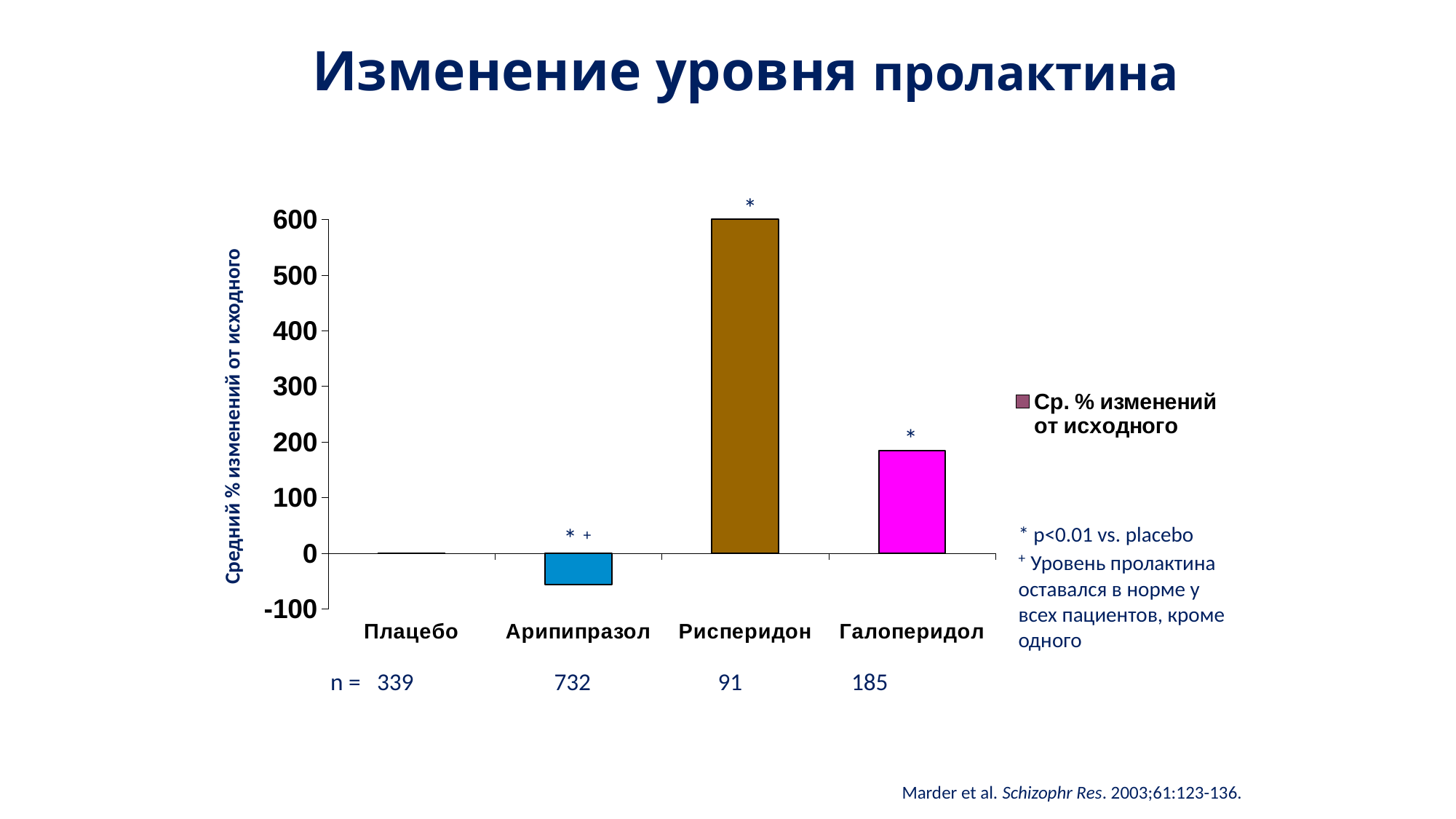
What is the n (number of patients) shown under the Арипипразол bar? 732 Which has the larger mean % change from baseline, Галоперидол or Арипипразол? Галоперидол Which category has the lowest mean % change from baseline in prolactin level? Арипипразол Is the value for Арипипразол greater or less than 0? less What is the legend entry for the plotted series? Ср. % изменений от исходного Is the value for Галоперидол greater or less than 200? less Is the value for Галоперидол greater or less than 100? greater How many series does the chart legend list? 1 Which has the larger mean % change from baseline, Рисперидон or Галоперидол? Рисперидон How many categories are plotted on the x axis of the chart? 4 What kind of chart is shown on the slide? bar chart Which category has the highest mean % change from baseline in prolactin level? Рисперидон